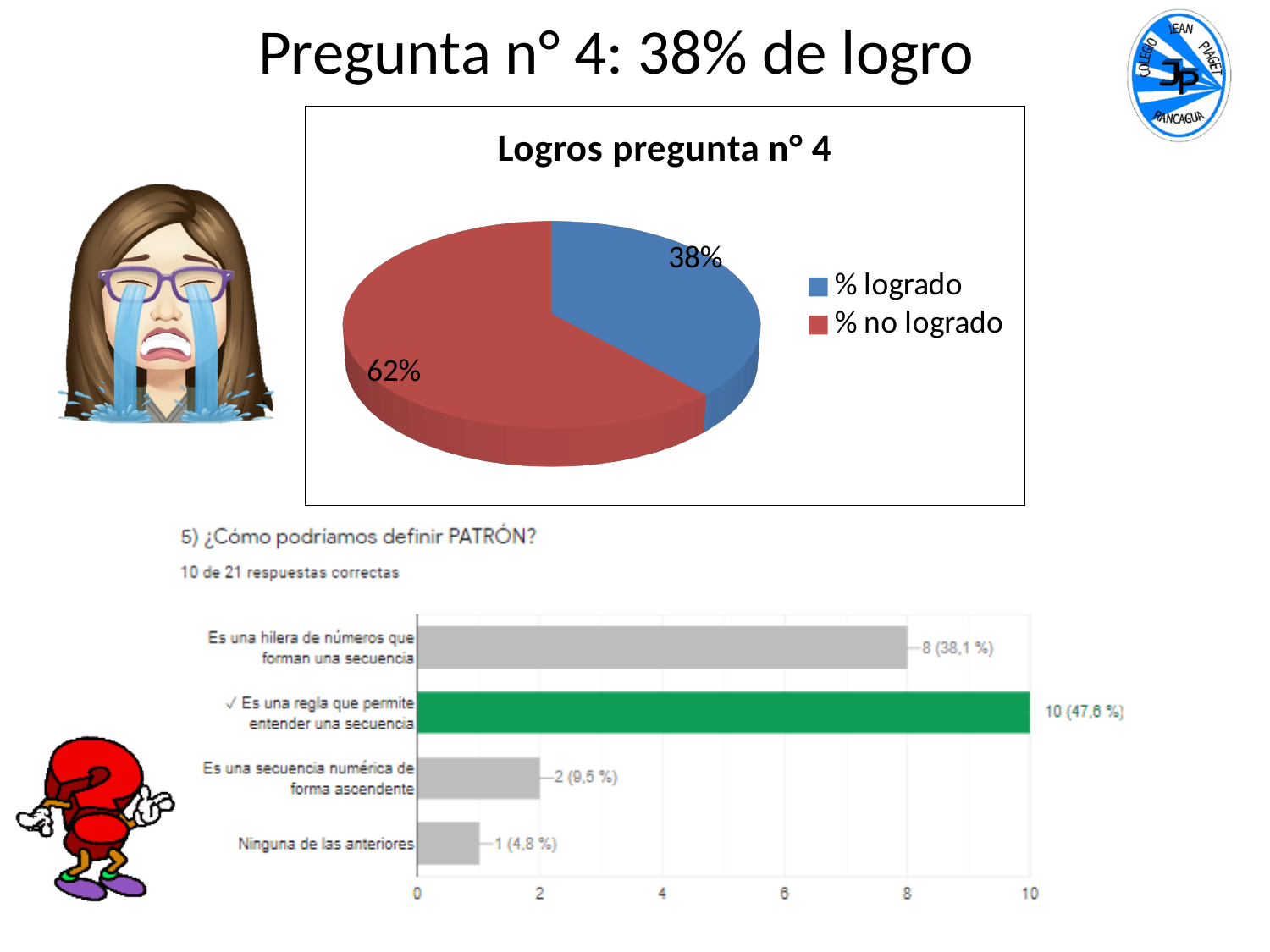
In the pie chart titled "Logros pregunta n° 4", what colour is the "% no logrado" slice? Red How many entries does the legend of the pie chart titled "Logros pregunta n° 4" list? 2 In the pie chart titled "Logros pregunta n° 4", what is the difference between "% no logrado" and "% logrado"? 24% In the pie chart titled "Logros pregunta n° 4", what is the value for "% logrado"? 38% In the pie chart titled "Logros pregunta n° 4", what is the value for "% no logrado"? 62% What kind of chart is the chart at the bottom of the slide for question 5 "¿Cómo podríamos definir PATRÓN?"? Bar chart In the bar chart at the bottom of the slide, what is the value for "Es una regla que permite entender una secuencia"? 10 (47,6 %) In the bar chart at the bottom of the slide, which answer option has the lowest value? Ninguna de las anteriores What kind of chart is the chart titled "Logros pregunta n° 4"? Pie chart In the pie chart titled "Logros pregunta n° 4", which slice is larger, "% logrado" or "% no logrado"? % no logrado In the bar chart at the bottom of the slide, how many answer options (bars) are shown? 4 In the bar chart at the bottom of the slide, what is the difference in count between "Es una hilera de números que forman una secuencia" and "Es una secuencia numérica de forma ascendente"? 6